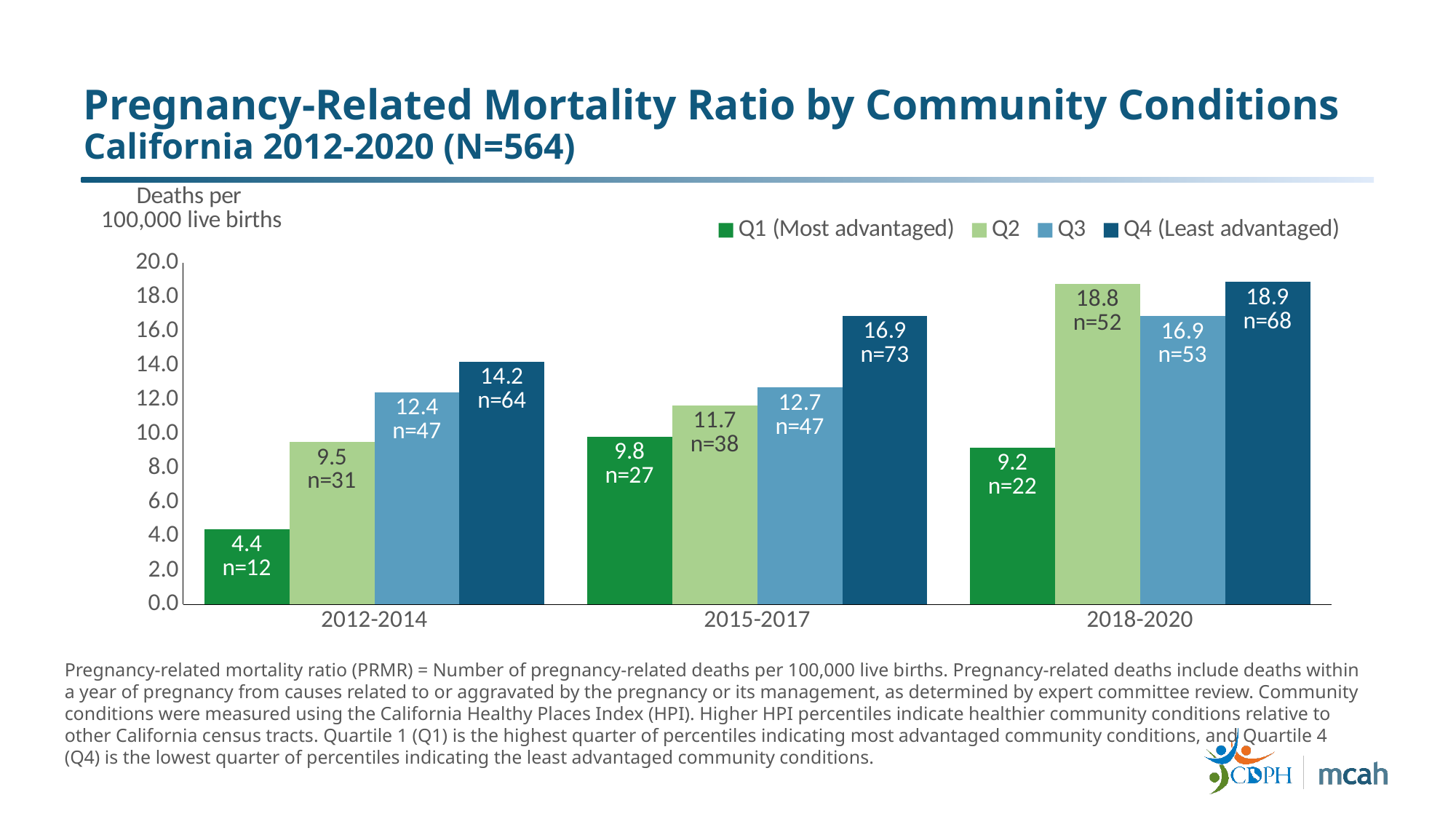
Which is larger, the Q2 value in 2015-2017 or the Q3 value in 2012-2014? Q3 value in 2012-2014 What kind of chart is shown on the slide? Bar chart How many deaths (n) are shown for Q2 in 2018-2020? n=52 Which quartile has the highest mortality ratio in 2015-2017? Q4 (Least advantaged) What is the value for Q4 (Least advantaged) in 2018-2020? 18.9 What is the pregnancy-related mortality ratio for Q1 (Most advantaged) in 2012-2014? 4.4 What is the value for Q3 in 2015-2017? 12.7 How many time periods are shown on the x axis? 3 What is the difference between the Q4 (Least advantaged) and Q1 (Most advantaged) values in 2012-2014? 9.8 Does the Q4 (Least advantaged) value rise or fall across the three time periods? Rise How many series does the legend list? 4 Which quartile has the lowest mortality ratio in 2018-2020? Q1 (Most advantaged)